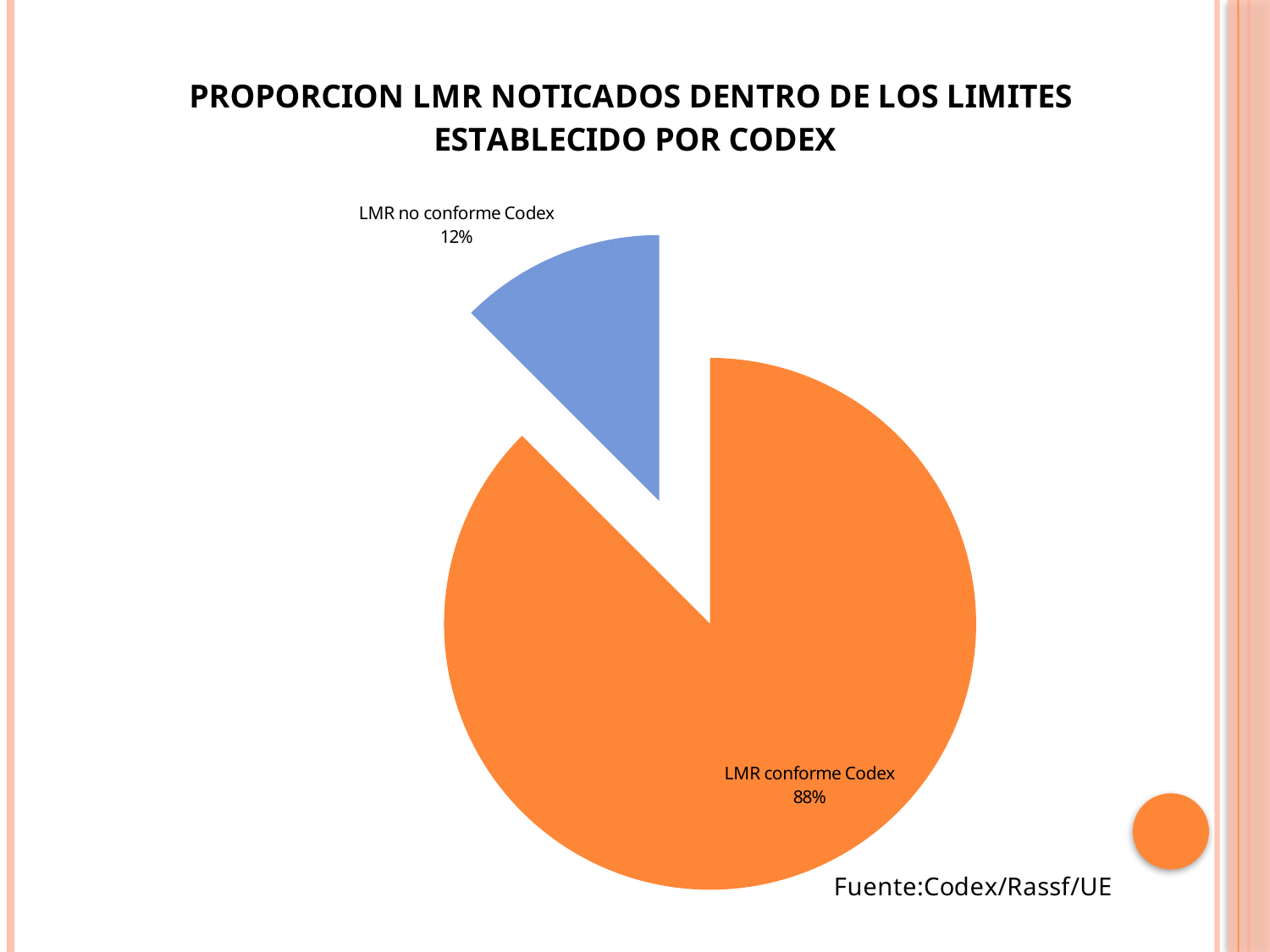
What share of the pie does "LMR no conforme Codex" represent? 12% How many slices does the pie chart have? 2 What kind of chart is shown on the slide? pie chart Which is larger, the "LMR conforme Codex" slice or the "LMR no conforme Codex" slice? LMR conforme Codex What is the difference in percentage points between the "LMR conforme Codex" and "LMR no conforme Codex" slices? 76 What colour is the "LMR no conforme Codex" slice? blue Which slice of the pie is the smallest? LMR no conforme Codex Which slice of the pie is the largest? LMR conforme Codex What is the title of the chart? PROPORCION LMR NOTICADOS DENTRO DE LOS LIMITES ESTABLECIDO POR CODEX What share of the pie does "LMR conforme Codex" represent? 88% What is the source cited below the chart? Fuente:Codex/Rassf/UE